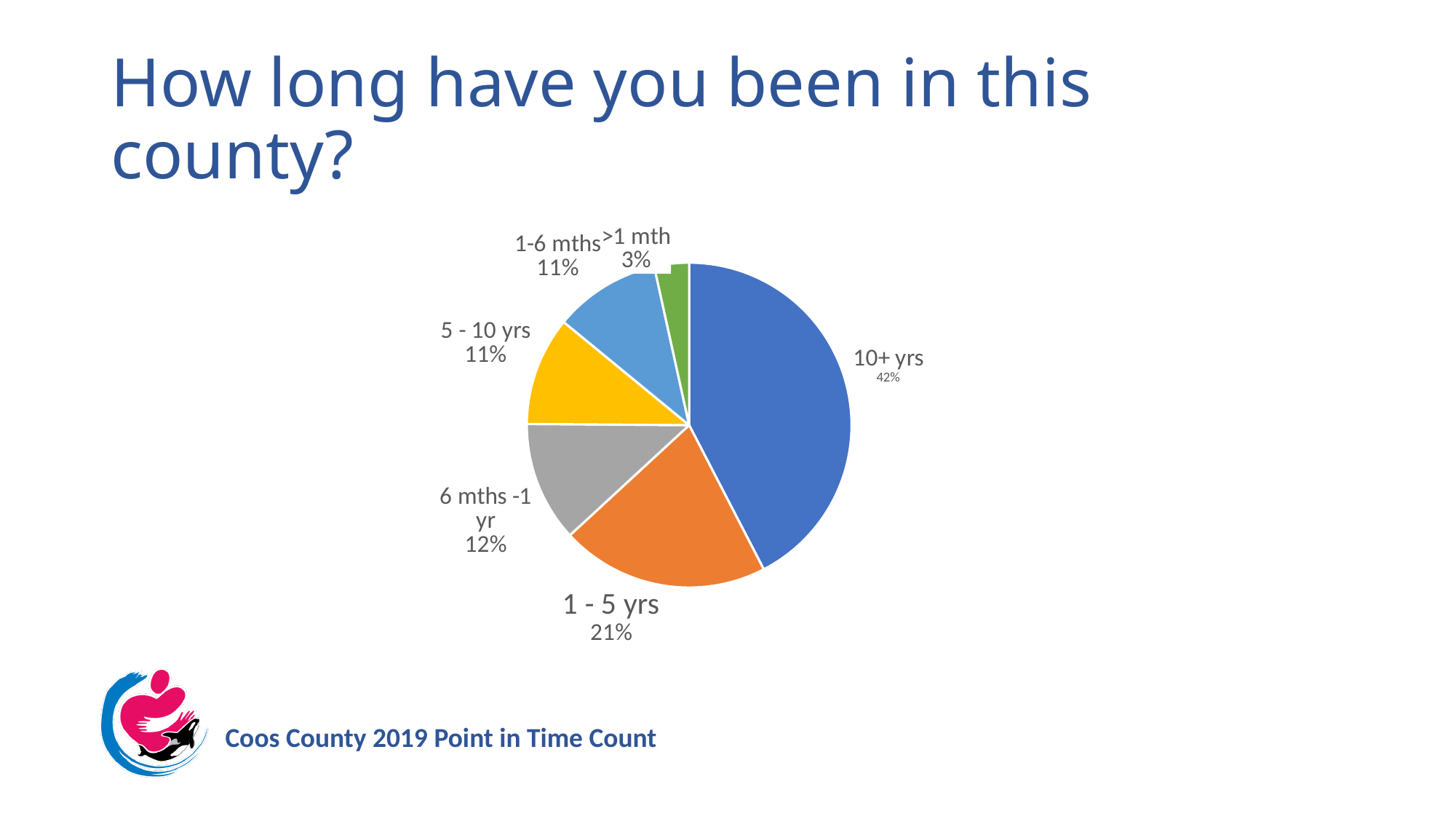
How many slices does the pie chart have? 6 Which category has the largest slice of the pie? 10+ yrs What colour is the "1 - 5 yrs" slice? orange What share of the pie is the ">1 mth" slice? 3% Which category has the smallest slice of the pie? >1 mth What share of the pie is the "10+ yrs" slice? 42% What share of the pie is the "1 - 5 yrs" slice? 21% Which is larger, the "6 mths -1 yr" slice or the "1-6 mths" slice? 6 mths -1 yr What is the difference in percentage points between the "10+ yrs" slice and the "1 - 5 yrs" slice? 21 What kind of chart is shown on the slide? pie chart